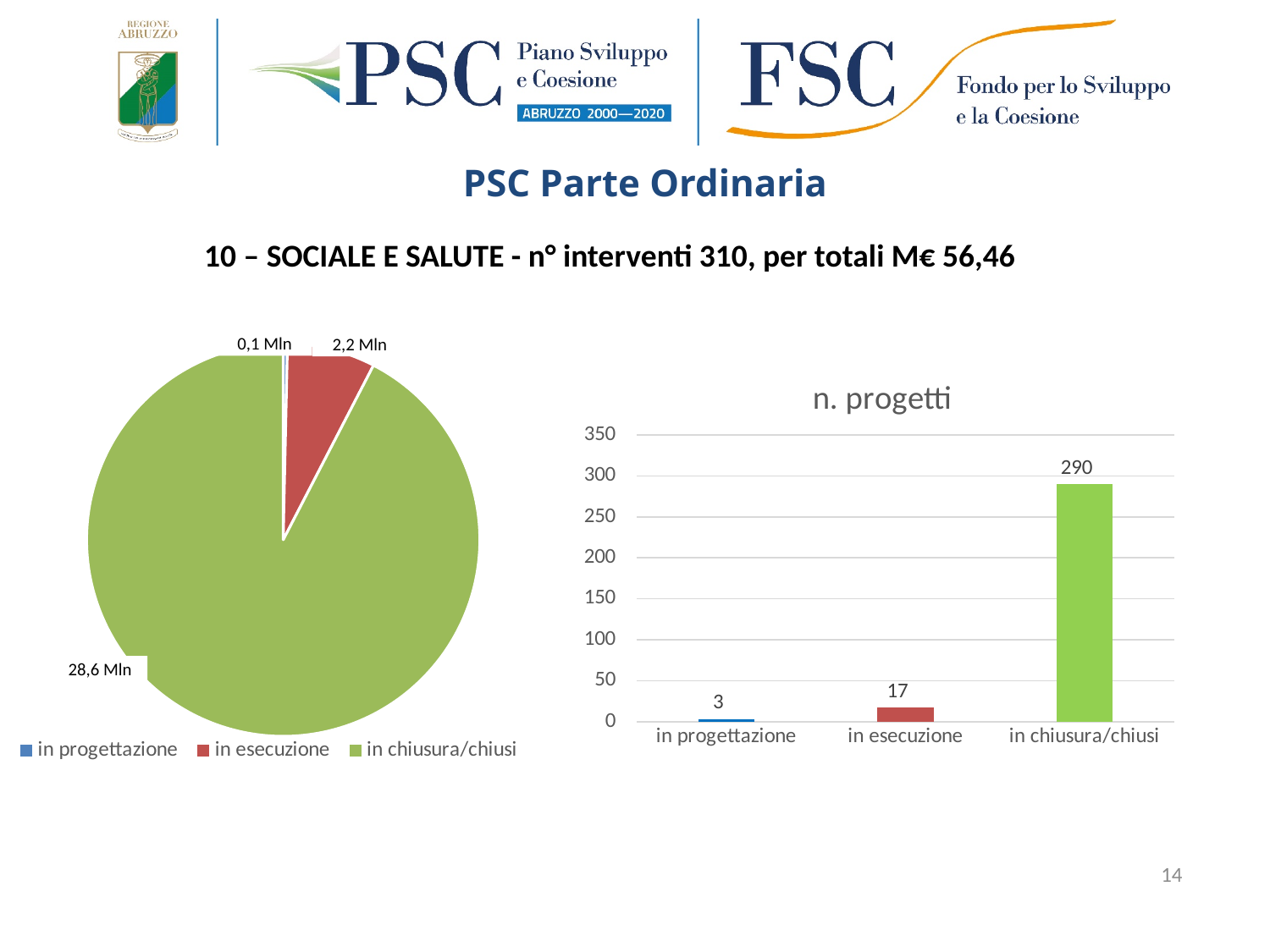
What kind of chart is the chart on the right of the slide, titled "n. progetti"? bar chart How many entries does the legend of the pie chart on the left of the slide list? 3 In the bar chart titled "n. progetti", what is the value for "in esecuzione"? 17 In the bar chart titled "n. progetti", what is the value for "in chiusura/chiusi"? 290 In the bar chart titled "n. progetti", how many categories are shown on the x axis? 3 In the bar chart titled "n. progetti", which category has the lowest value? in progettazione In the bar chart titled "n. progetti", which category has the highest value? in chiusura/chiusi In the bar chart titled "n. progetti", what is the difference between the values for "in chiusura/chiusi" and "in esecuzione"? 273 In the pie chart on the left of the slide, which slice is the smallest? in progettazione In the bar chart titled "n. progetti", what is the value for "in progettazione"? 3 In the pie chart on the left of the slide, what is the value labelled for the "in chiusura/chiusi" slice? 28,6 Mln In the pie chart on the left of the slide, what is the value labelled for the "in esecuzione" slice? 2,2 Mln